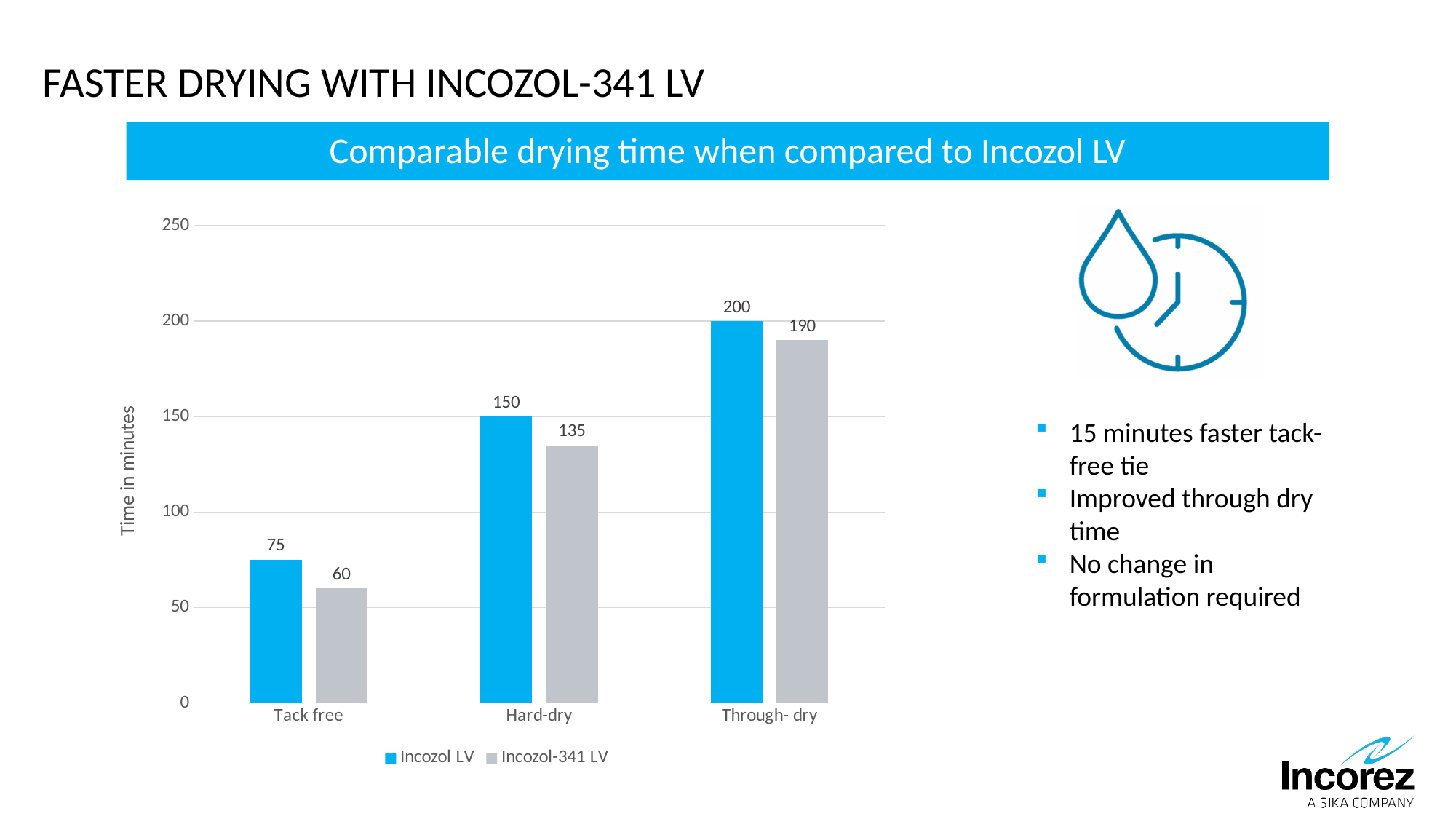
What is the difference between Incozol LV and Incozol-341 LV for Hard-dry? 15 What is the label of the vertical axis? Time in minutes Which is larger for Through- dry: Incozol LV or Incozol-341 LV? Incozol LV What is the difference between Incozol LV and Incozol-341 LV for Tack free? 15 What is the Through- dry time for Incozol LV? 200 How many series does the legend list? 2 What is the Tack free time for Incozol LV? 75 Which category has the lowest value for Incozol LV? Tack free How many categories are shown on the x axis? 3 What is the Hard-dry time for Incozol-341 LV? 135 What kind of chart is shown on the slide? Bar chart Which category has the highest value for Incozol-341 LV? Through- dry